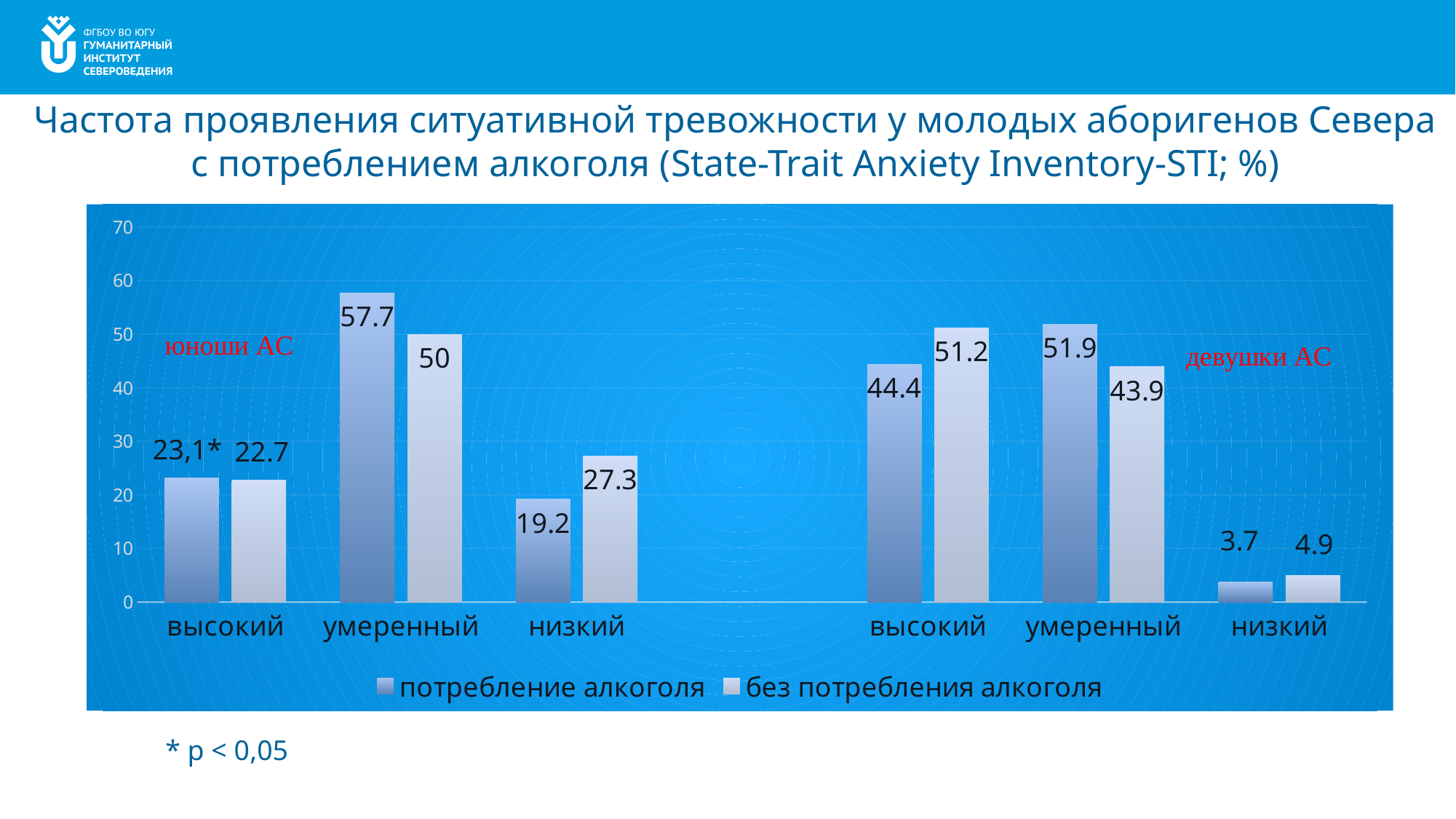
Is the value for 'умеренный' in the 'потребление алкоголя' series for the девушки АС group greater or less than 50? greater What is the value for 'низкий' in the 'потребление алкоголя' series for the юноши АС group? 19.2 Which category has the highest value in the 'потребление алкоголя' series for the юноши АС group? умеренный What kind of chart is shown on the slide? bar chart What is the difference between the 'потребление алкоголя' and 'без потребления алкоголя' values for 'умеренный' in the юноши АС group? 7.7 Which value on the chart is marked with an asterisk indicating p < 0,05? 23,1 Which category has the lowest value in the 'без потребления алкоголя' series for the девушки АС group? низкий What is the value for 'высокий' in the 'без потребления алкоголя' series for the девушки АС group? 51.2 How many series does the legend list? 2 For 'высокий' in the девушки АС group, which series has the larger value: 'потребление алкоголя' or 'без потребления алкоголя'? без потребления алкоголя What is the value for 'низкий' in the 'без потребления алкоголя' series for the девушки АС group? 4.9 What is the value for 'умеренный' in the 'потребление алкоголя' series for the юноши АС group? 57.7